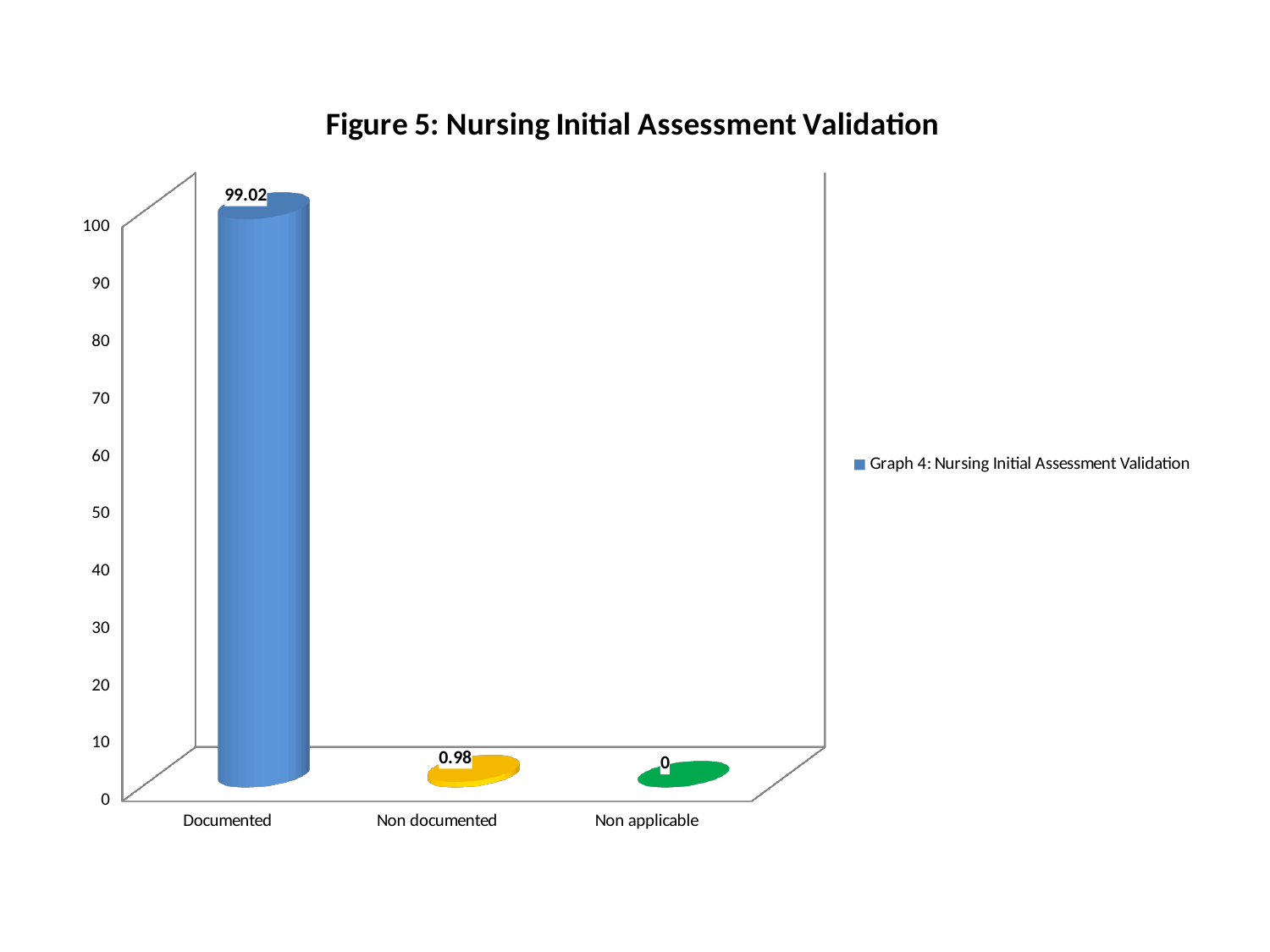
Which is larger, the value for Non documented or the value for Non applicable? Non documented How many series does the legend list? 1 What is the value for Documented? 99.02 What is the title of the chart? Figure 5: Nursing Initial Assessment Validation What kind of chart is shown on the slide? bar chart What is the difference between the values for Documented and Non documented? 98.04 How many categories are shown on the x axis? 3 Which category has the lowest value? Non applicable What is the value for Non applicable? 0 Is the value for Documented greater or less than 90? greater What is the value for Non documented? 0.98 Which category has the highest value? Documented